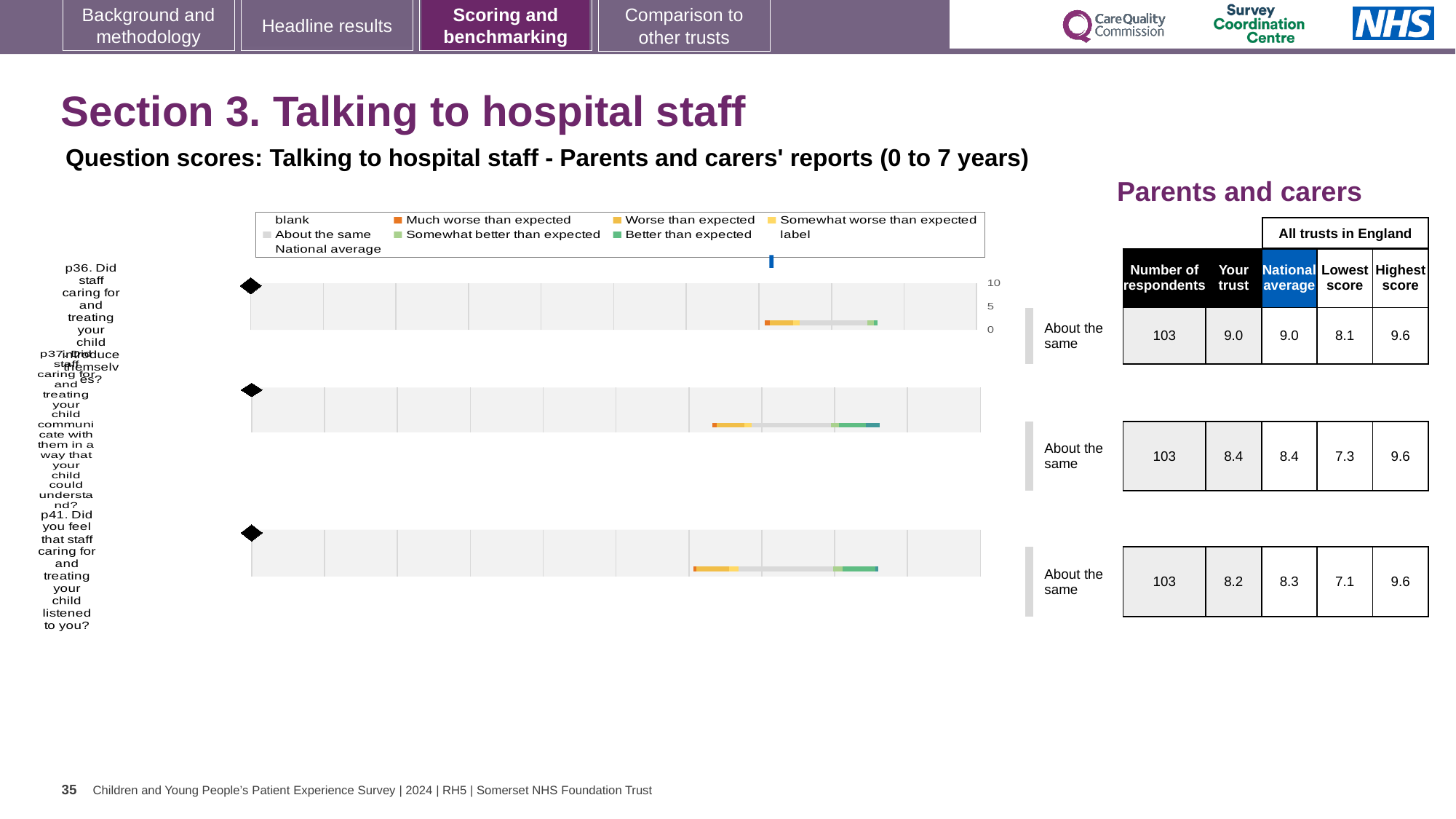
Which question has the lowest 'Your trust' score? p41 What is the national average score for question p41 (Did you feel that staff caring for and treating your child listened to you)? 8.3 What kind of chart is used to show the question scores on this slide? bar chart Which legend entry is shown in orange? Much worse than expected What is the lowest score among all trusts in England for question p37? 7.3 How many survey questions (charts) are plotted on the slide? 3 What is the 'Your trust' score for question p36 (Did staff caring for and treating your child introduce themselves)? 9.0 Is the 'Your trust' score for p37 greater or less than 5? greater Which question has the highest 'Your trust' score? p36 What is the highest tick value shown on the score axis of the charts? 10 What is the difference between the 'Your trust' scores for p36 and p41? 0.8 How many respondents answered question p36? 103